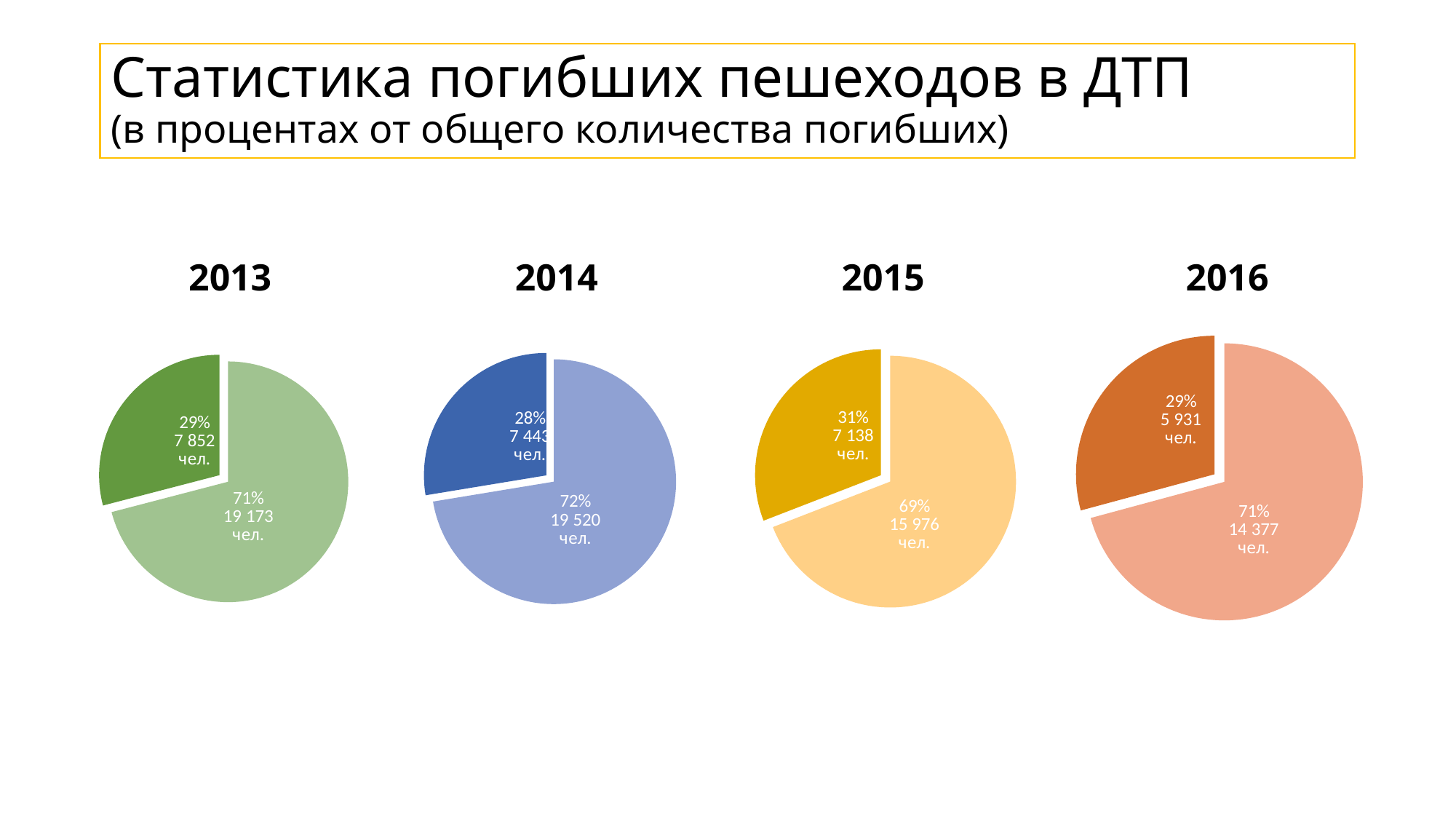
Which is larger: the number of people in the smaller slice of the 2013 pie chart or the smaller slice of the 2016 pie chart? 2013 (7 852) In the 2014 pie chart, what percentage is shown on the larger slice? 72% How many slices does each pie chart have? 2 Which year's pie chart shows the lowest percentage for the smaller, exploded slice? 2014 What kind of charts are shown on the slide? Pie charts In the 2013 pie chart, how many people (чел.) does the larger slice represent? 19 173 чел. In the 2013 pie chart, what percentage is shown on the smaller, exploded slice? 29% What is the difference in people between the larger slice of the 2014 pie chart (19 520) and the larger slice of the 2016 pie chart (14 377)? 5 143 How many pie charts are on the slide? 4 In the 2016 pie chart, how many people (чел.) does the larger slice represent? 14 377 чел. In the 2015 pie chart, how many people (чел.) does the smaller, exploded slice represent? 7 138 чел. Which year's pie chart shows the highest percentage for the smaller, exploded slice? 2015